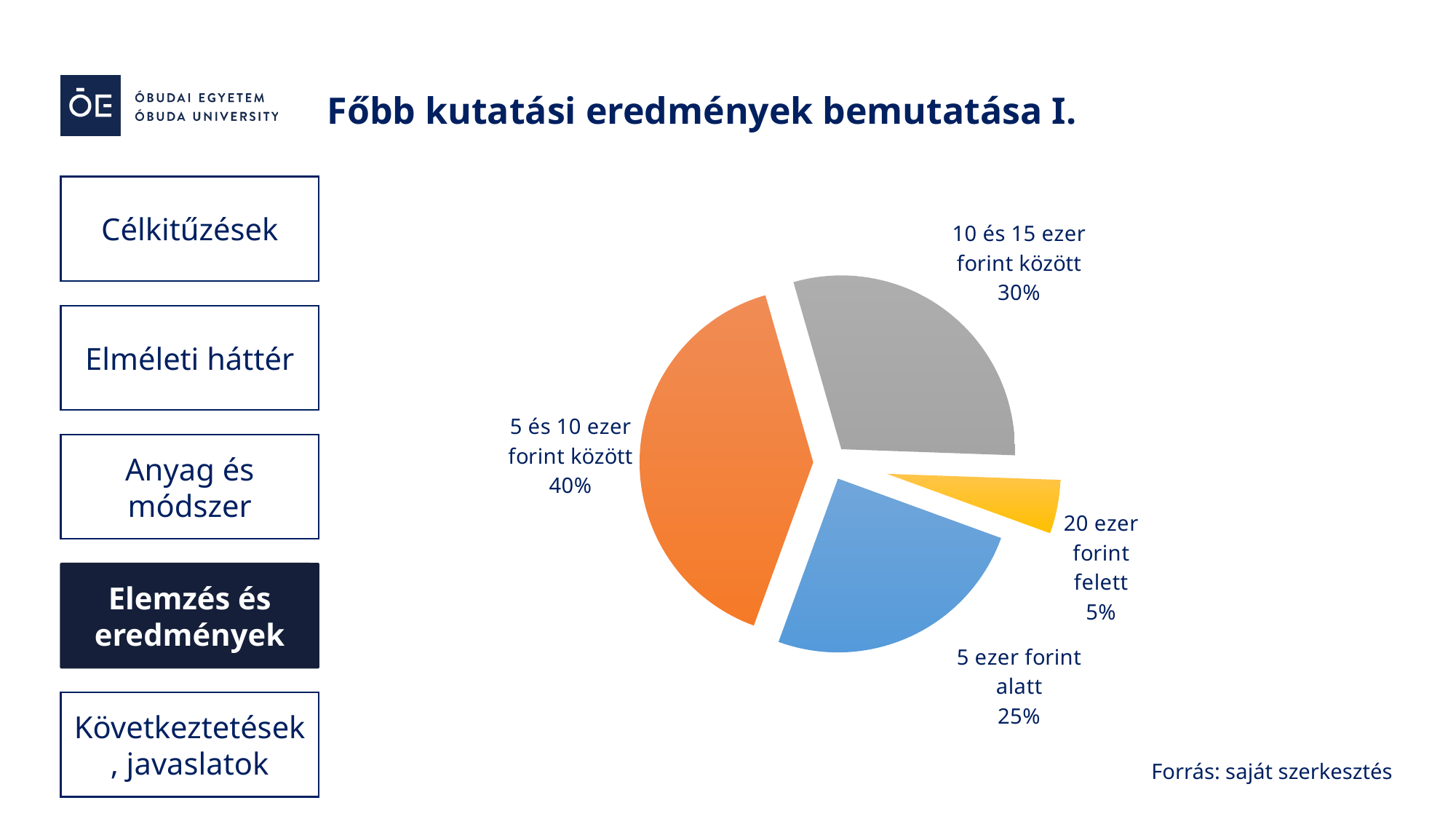
What colour is the "5 ezer forint alatt" slice? blue What share of the pie is labelled "5 ezer forint alatt"? 25% What source is given for the chart at the bottom right of the slide? Forrás: saját szerkesztés What is the difference in percentage points between the "5 és 10 ezer forint között" slice and the "5 ezer forint alatt" slice? 15 percentage points Which slice of the pie chart is the smallest? 20 ezer forint felett What share of the pie is labelled "20 ezer forint felett"? 5% Which slice of the pie chart is the largest? 5 és 10 ezer forint között What kind of chart is shown on the slide? pie chart How many slices does the pie chart have? 4 Which is larger: the "10 és 15 ezer forint között" slice or the "5 ezer forint alatt" slice? 10 és 15 ezer forint között What share of the pie is labelled "5 és 10 ezer forint között"? 40% What share of the pie is labelled "10 és 15 ezer forint között"? 30%